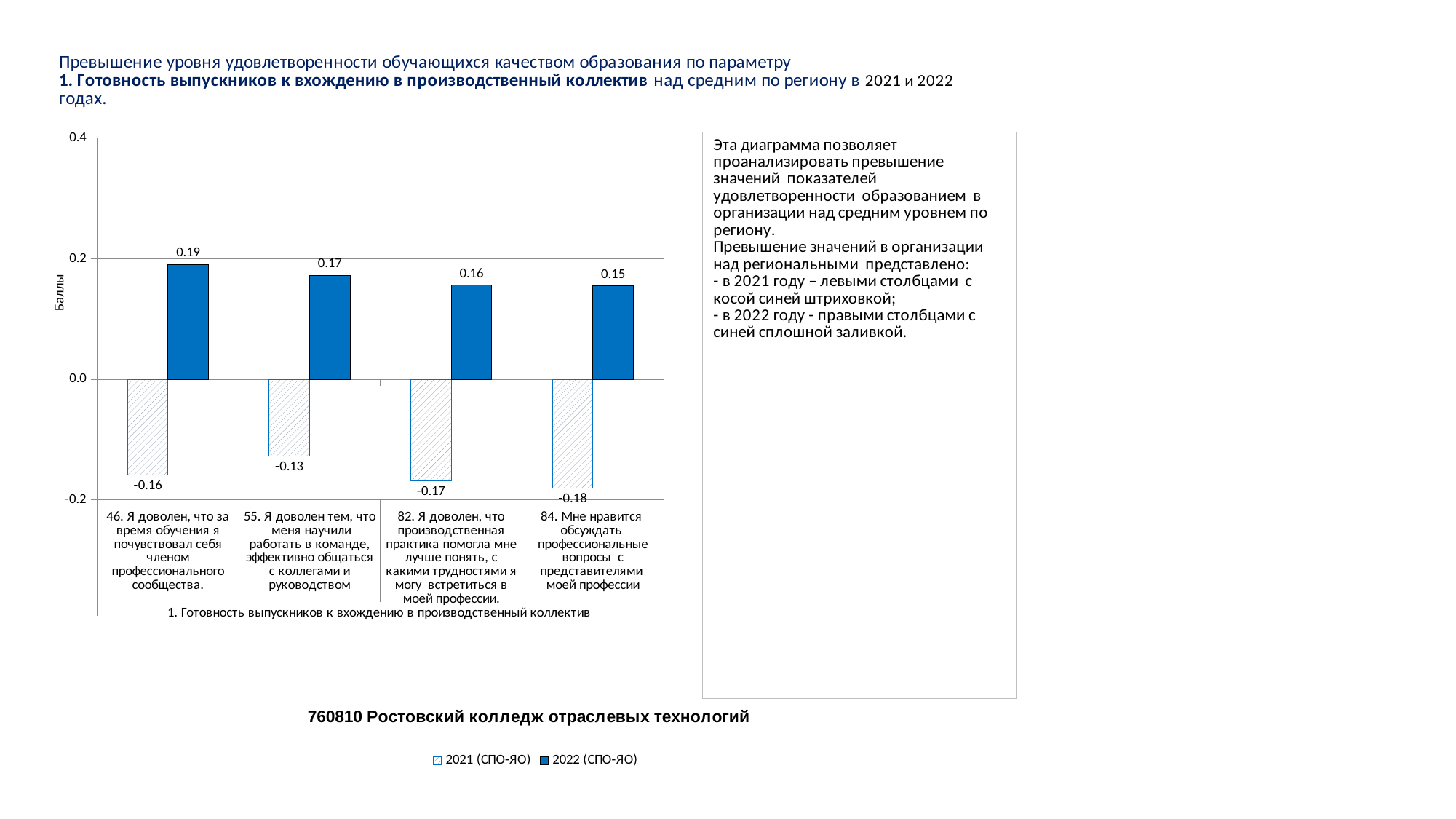
What is the 2021 (СПО-ЯО) value for question 84 (Мне нравится обсуждать профессиональные вопросы с представителями моей профессии)? -0.18 What type of chart is shown on the slide? bar chart What is the 2022 (СПО-ЯО) value for question 46 (Я доволен, что за время обучения я почувствовал себя членом профессионального сообщества)? 0.19 Which category has the lowest 2021 (СПО-ЯО) value? 84. Мне нравится обсуждать профессиональные вопросы с представителями моей профессии Which is larger for question 55: the 2022 (СПО-ЯО) value or the 2022 (СПО-ЯО) value for question 84? question 55 (0.17) What is the 2021 (СПО-ЯО) value for question 55 (Я доволен тем, что меня научили работать в команде)? -0.13 How many categories (questions) are shown on the x axis of the chart? 4 How many series does the chart legend list? 2 Which category has the highest 2022 (СПО-ЯО) value? 46. Я доволен, что за время обучения я почувствовал себя членом профессионального сообщества. What is the label of the y axis of the chart? Баллы What is the difference between the 2022 (СПО-ЯО) value and the 2021 (СПО-ЯО) value for question 82? 0.33 Do the 2022 (СПО-ЯО) values rise or fall from left to right across the categories? fall